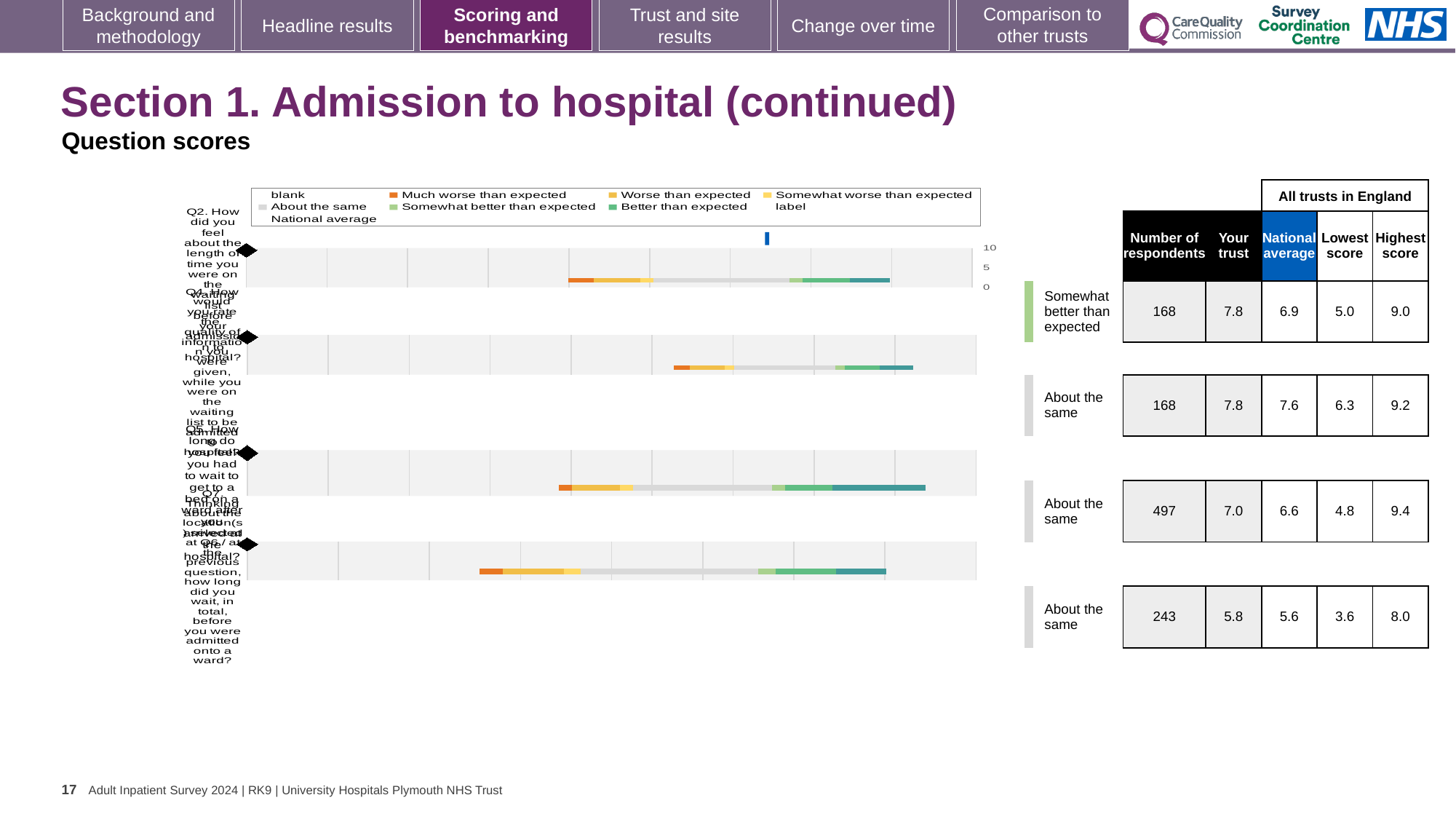
In the table beside the chart, what is the difference between 'Your trust' and the national average for the first row? 0.9 In the chart legend, which colour represents 'Better than expected'? teal How many question rows (bars) are plotted in the chart? 4 In the table beside the chart, which row has the highest number of respondents? the third row (497) In the table beside the chart, what is the 'Your trust' score for the first row (rated 'Somewhat better than expected')? 7.8 In the table beside the chart, how many respondents are listed for the third row? 497 In the chart legend, which colour represents 'Much worse than expected'? orange What kind of chart is shown on the slide? bar chart In the table beside the chart, what is the highest score among all trusts in England for the fourth row? 8.0 In the table beside the chart, is the 'Your trust' score for the fourth row larger or smaller than its national average? larger In the table beside the chart, what is the national average for the first row (rated 'Somewhat better than expected')? 6.9 In the table beside the chart, which row has the lowest 'Your trust' score? the fourth row (5.8)